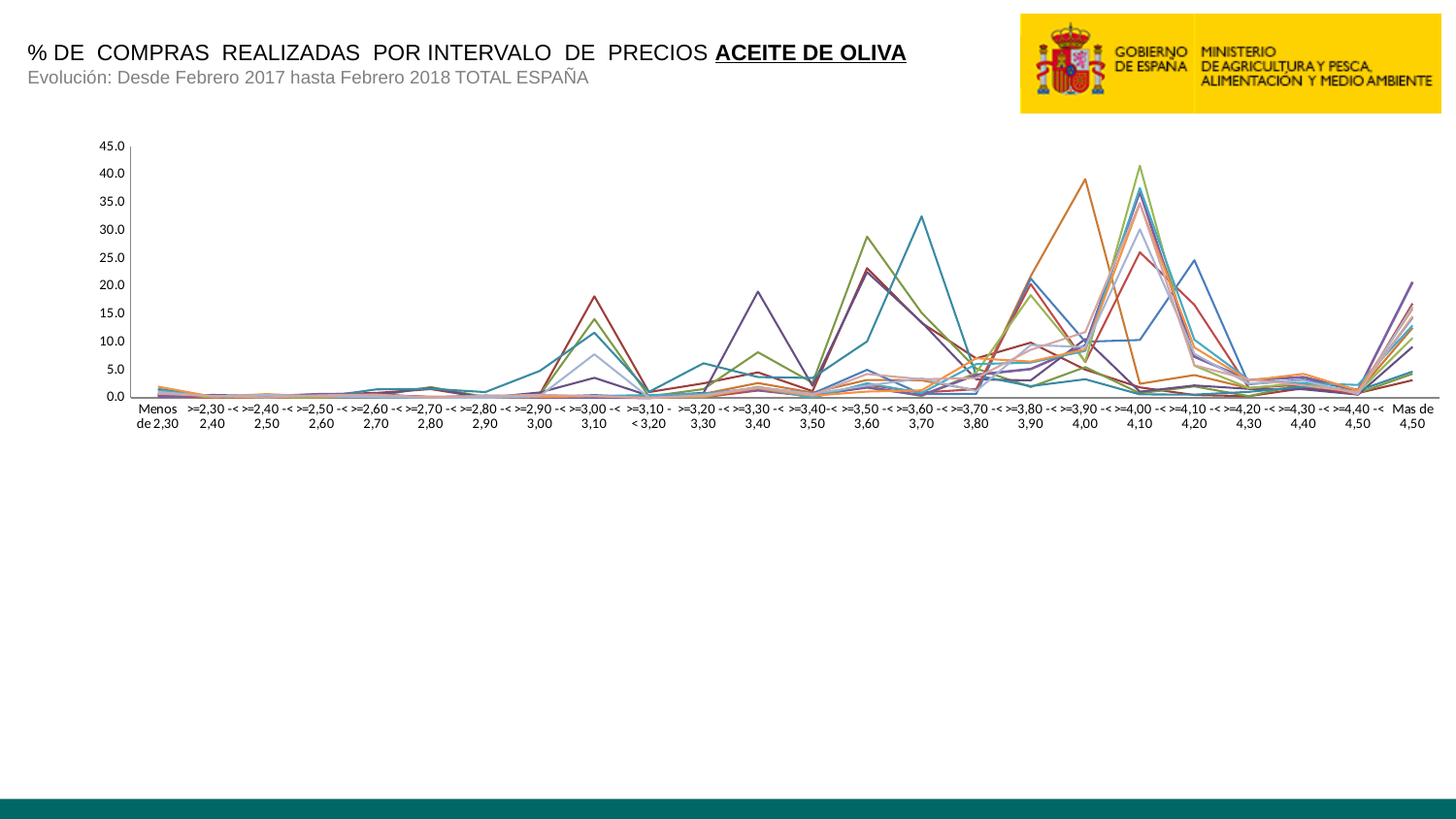
Does the chart display a legend identifying the series? No What kind of chart is shown on the slide? Line chart What is the highest tick value shown on the y axis? 45.0 What is the label of the last category on the x axis? Mas de 4,50 What is the label of the first category on the x axis? Menos de 2,30 In which category does the highest peak of the chart occur? >=4,00 -< 4,10 How many price-interval categories are shown along the x axis? 24 Are all the values plotted at '>=2,50 -< 2,60' greater or less than 5.0? less Is the highest value plotted on the chart greater or less than 40.0? greater Are all the values plotted at 'Menos de 2,30' greater or less than 5.0? less